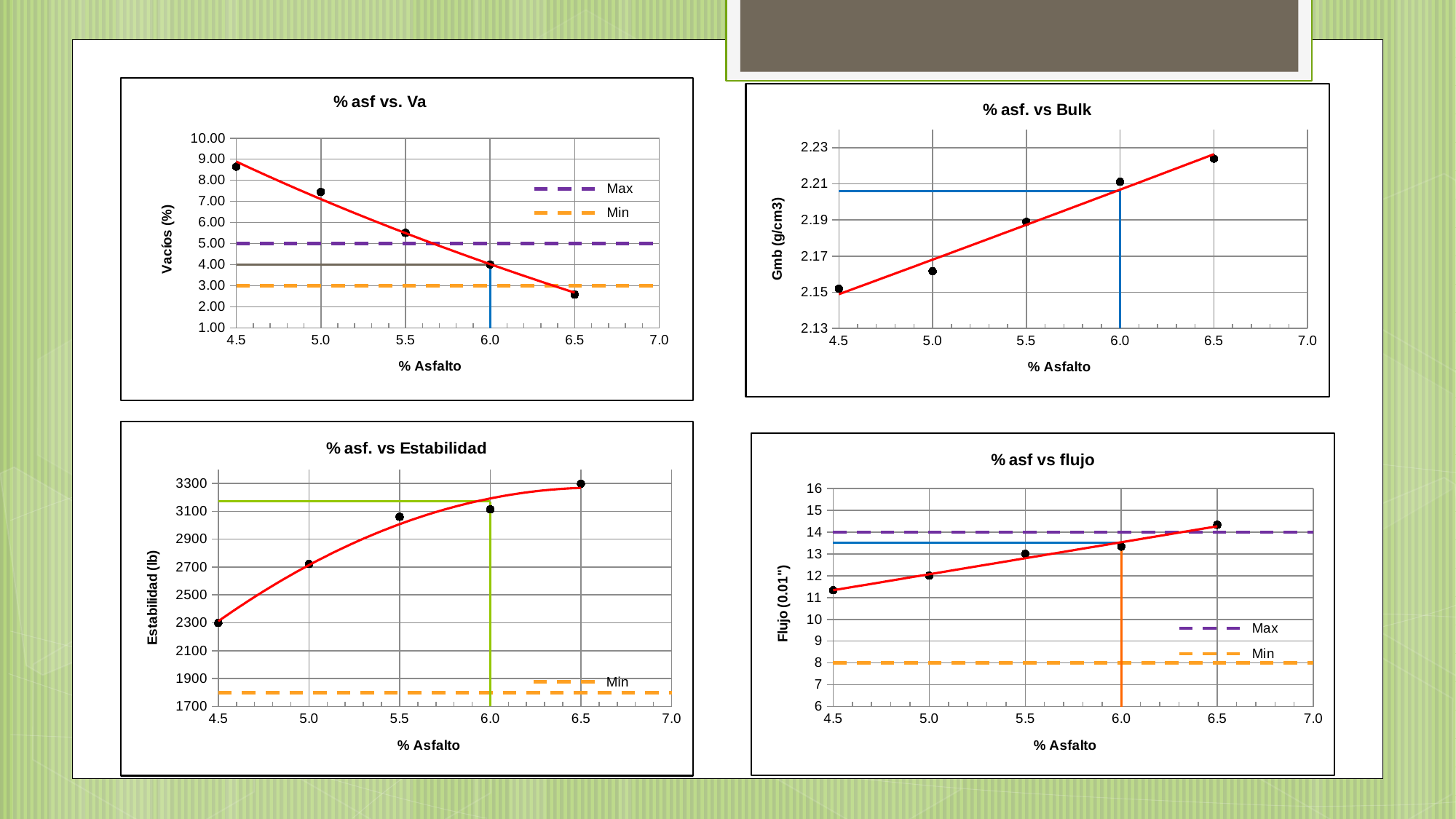
In the '% asf. vs Bulk' chart, at which % Asfalto is Gmb highest? 6.5 In the '% asf. vs Estabilidad' chart, at which % Asfalto is the stability lowest? 4.5 In the '% asf vs. Va' chart, how many data points are plotted? 5 In the '% asf vs flujo' chart, how many series does the legend list? 2 In the '% asf vs. Va' chart, is the value at 4.5 % Asfalto greater or less than 8.00? greater What kind of chart is the '% asf vs. Va' chart? line chart In the '% asf vs flujo' chart, what is the flow value at 5.0 % Asfalto? 12 In the '% asf. vs Bulk' chart, is the value at 5.0 % Asfalto greater or less than 2.17? less In the '% asf vs. Va' chart, which entries does the legend list? Max, Min In the '% asf. vs Bulk' chart, do the values rise or fall as % Asfalto increases? rise In the '% asf vs. Va' chart, do the plotted values rise or fall as % Asfalto increases? fall